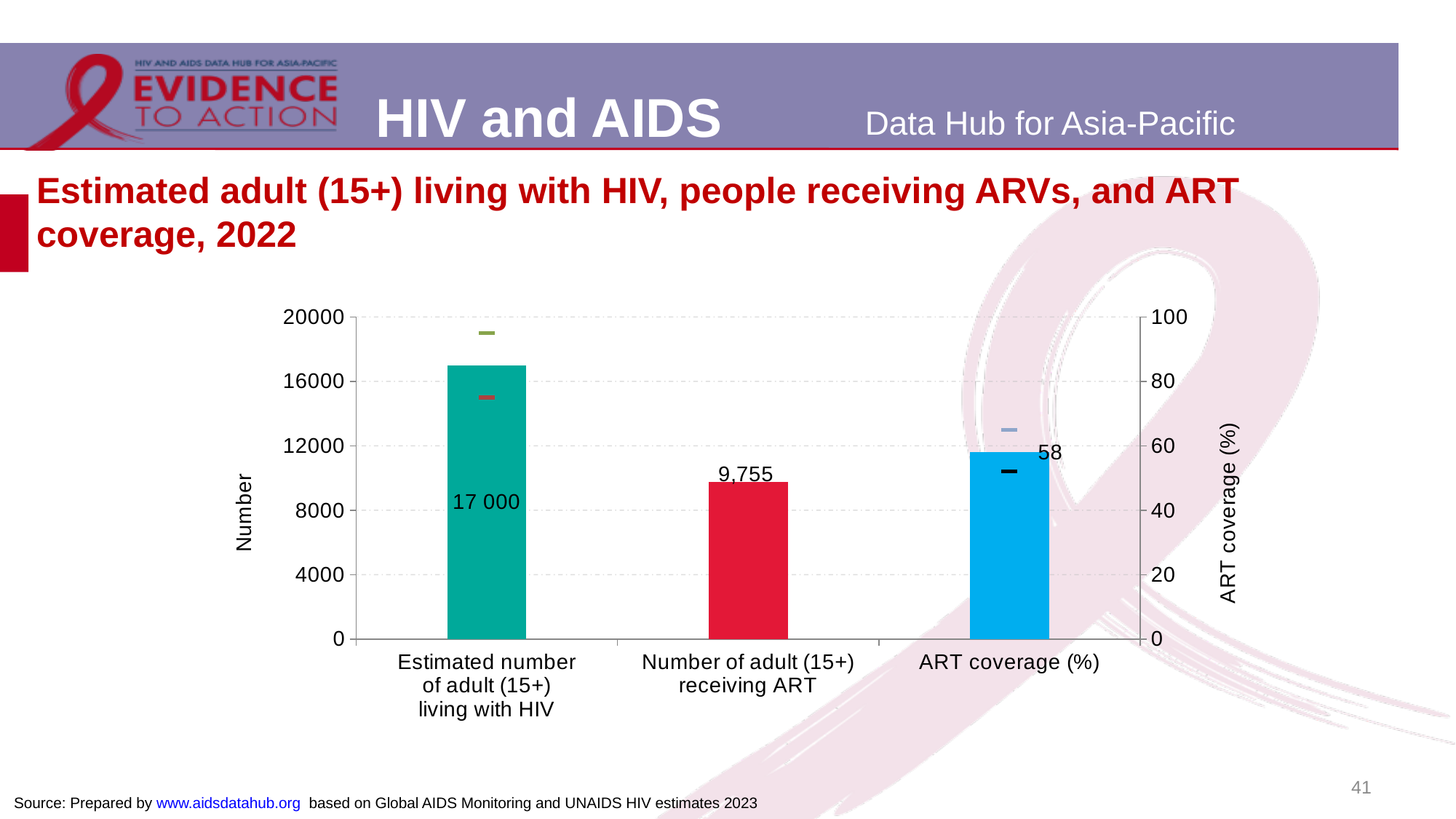
What is the title of the left vertical axis of the chart? Number Is the number of adults (15+) receiving ART greater or less than 8000? greater Which category has the tallest bar on the chart? Estimated number of adult (15+) living with HIV What is the ART coverage (%) value shown on the chart? 58 Which is larger: the estimated number of adults living with HIV or the number of adults receiving ART? Estimated number of adult (15+) living with HIV What is the number of adults (15+) receiving ART shown on the chart? 9,755 How many categories are shown on the x axis of the chart? 3 What kind of chart is shown on the slide? Bar chart What is the estimated number of adults (15+) living with HIV shown on the chart? 17 000 What is the difference between the estimated number of adults living with HIV and the number of adults receiving ART? 7,245 What is the title of the right vertical axis of the chart? ART coverage (%) Is the ART coverage (%) value greater or less than 60 on the right-hand axis? less